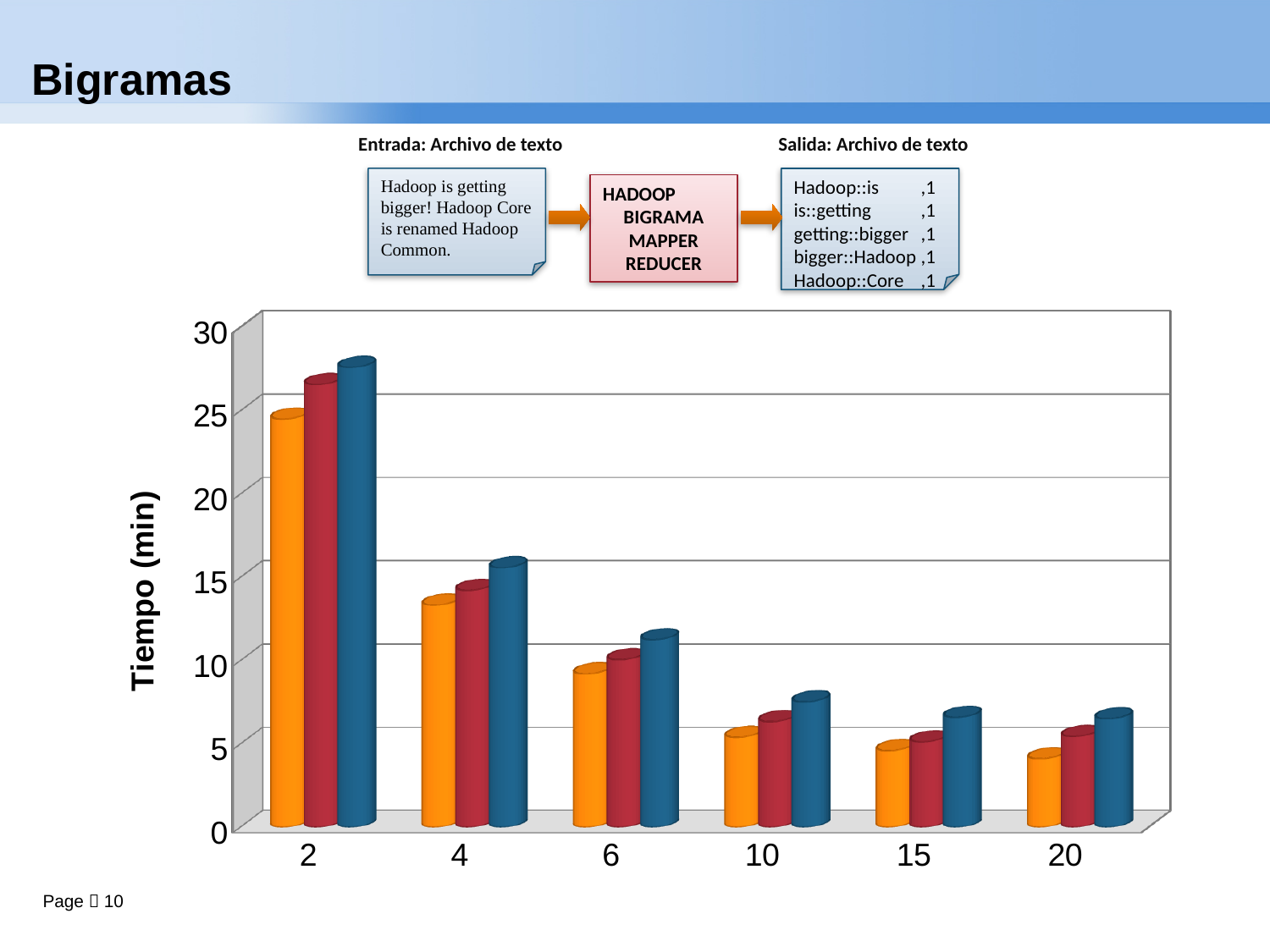
Is the value of the orange bar at category 20 greater or less than 5? less At category 2, which bar is taller, the orange bar or the blue bar? the blue bar Is the value of the orange bar at category 4 greater or less than 15? less What kind of chart is shown on the slide? bar chart Is the value of the blue bar at category 2 greater or less than 25? greater Which x-axis category has the tallest bars in the chart? 2 What is the title of the vertical axis of the chart? Tiempo (min) Do the bar heights rise or fall as the x-axis values increase from 2 to 20? fall How many bars are plotted for each category on the x axis? 3 How many categories are shown on the x axis of the chart? 6